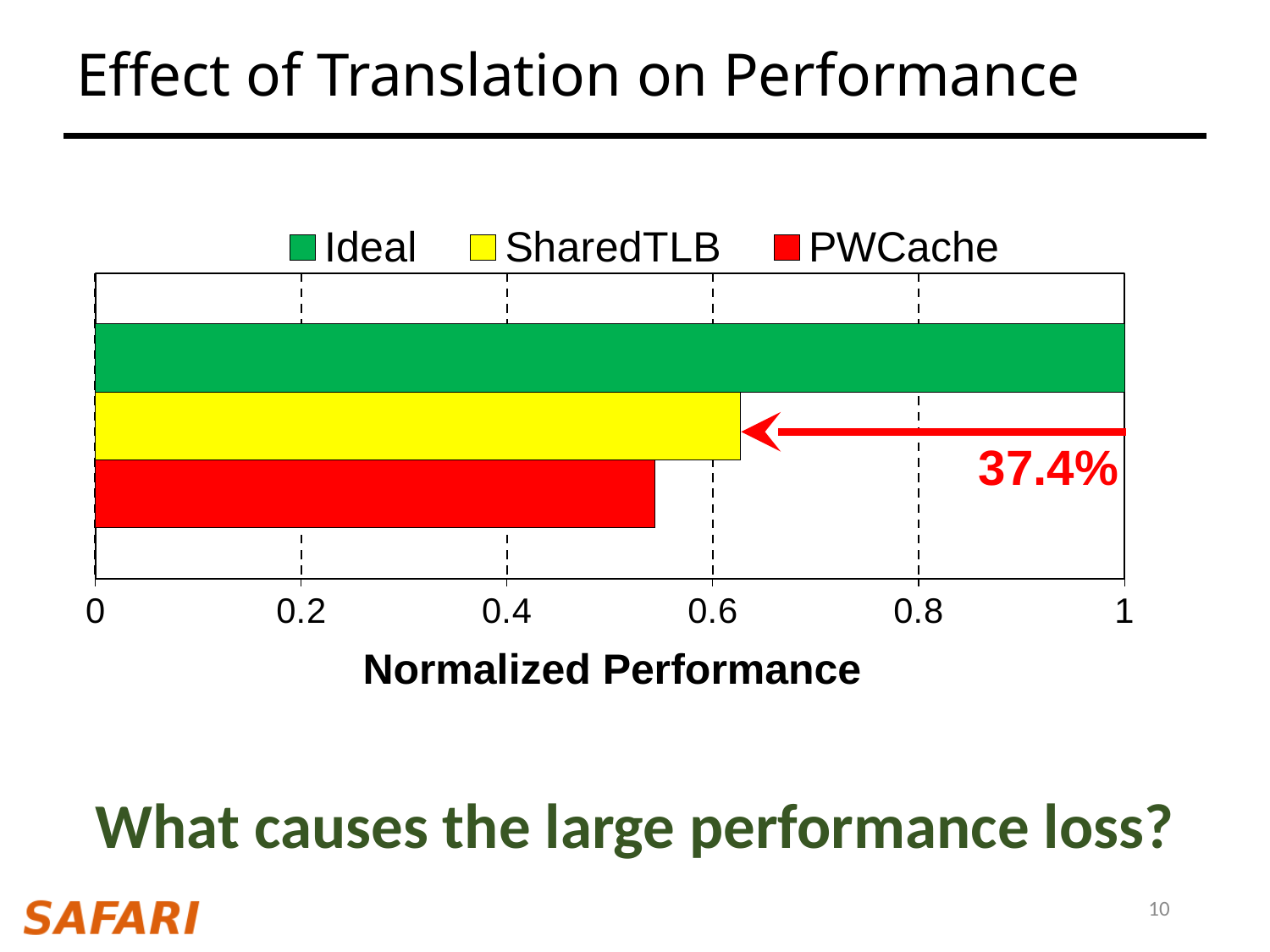
What is the normalized performance value for Ideal? 1 Is the value for PWCache greater or less than 0.4? greater Which series has the highest normalized performance? Ideal How many series does the legend list? 3 Is the value for PWCache greater or less than 0.6? less Which has a larger normalized performance, SharedTLB or PWCache? SharedTLB What kind of chart is shown on the slide? bar chart Which series has the lowest normalized performance? PWCache What percentage is printed in red next to the arrow on the chart? 37.4% Is the value for SharedTLB greater or less than 0.6? greater What is the label of the x axis? Normalized Performance How many bars are plotted in the chart? 3